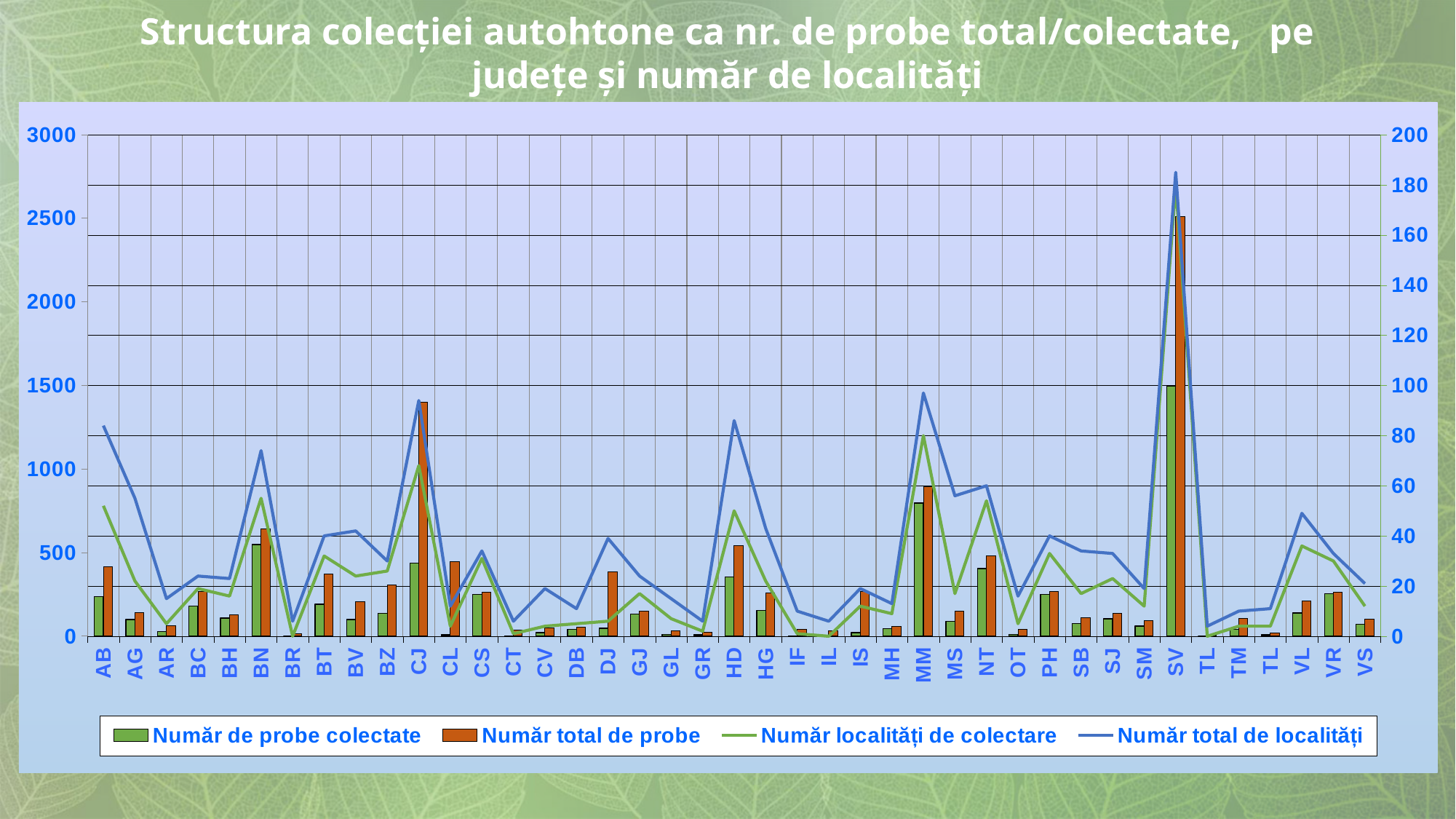
Is the Număr total de probe value for SV greater or less than 2000? greater How many series does the legend list? 4 Which county has the highest value for Număr total de probe? SV Is the Număr total de probe value for CJ greater or less than 1000? greater Which is larger, the Număr total de probe for BN or for AB? BN How many county categories are shown along the x axis? 41 What is the maximum value shown on the right-hand vertical axis? 200 Which county has the highest value for Număr de probe colectate? SV Is the Număr total de probe value for AB greater or less than 500? less Which is larger, the Număr total de probe for CJ or for MM? CJ What kind of chart is shown on the slide? A combined bar and line chart